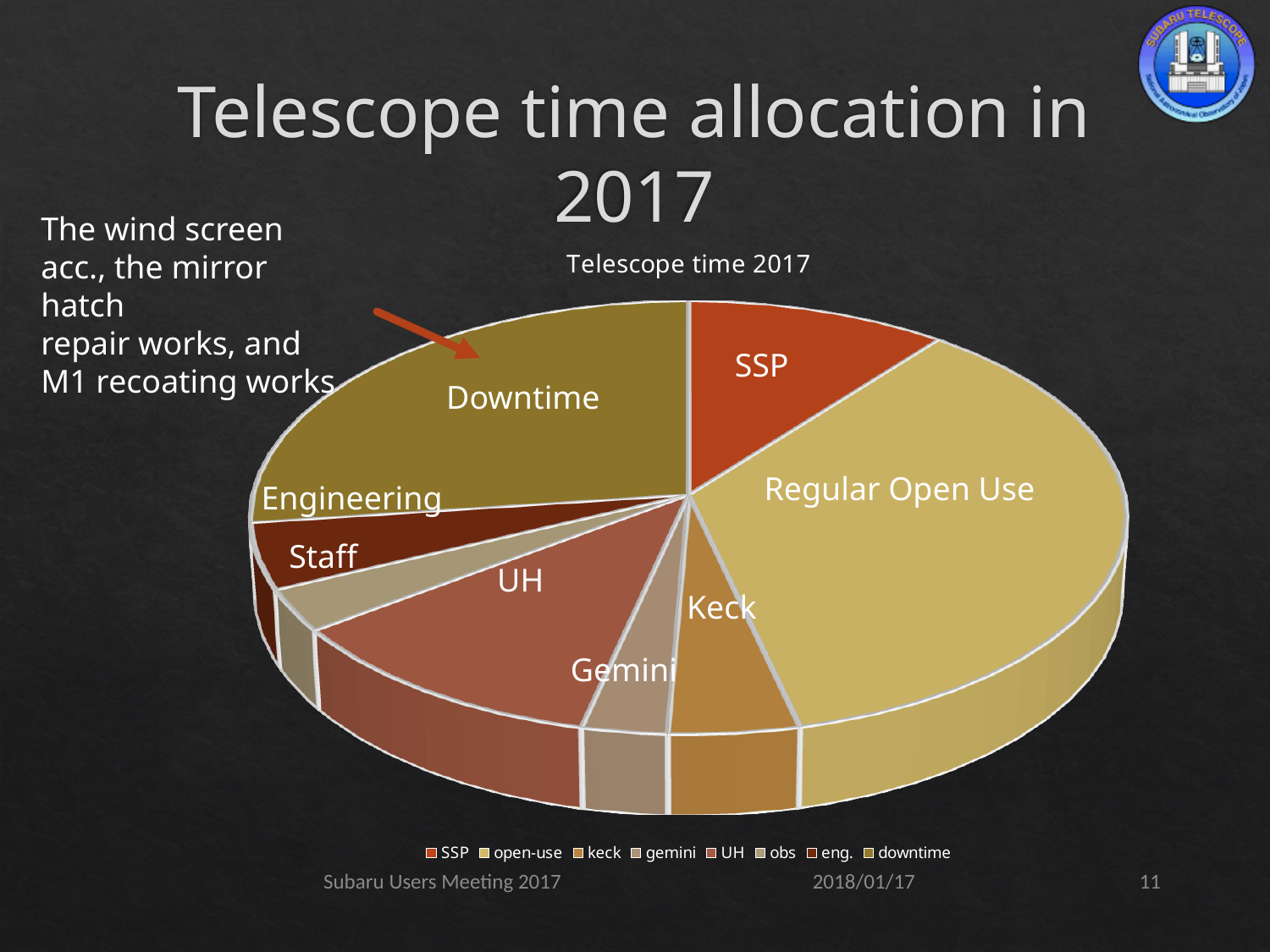
Which is larger, the Regular Open Use slice or the SSP slice? Regular Open Use Which slice does the red arrow on the slide point to? Downtime How many slices does the pie chart have? 8 Which is larger, the Downtime slice or the Staff slice? Downtime Which is larger, the Downtime slice or the Keck slice? Downtime How many entries does the chart legend list? 8 What kind of chart is shown on the slide? pie chart Which slice of the pie chart is the largest? Regular Open Use What is the title of the chart? Telescope time 2017